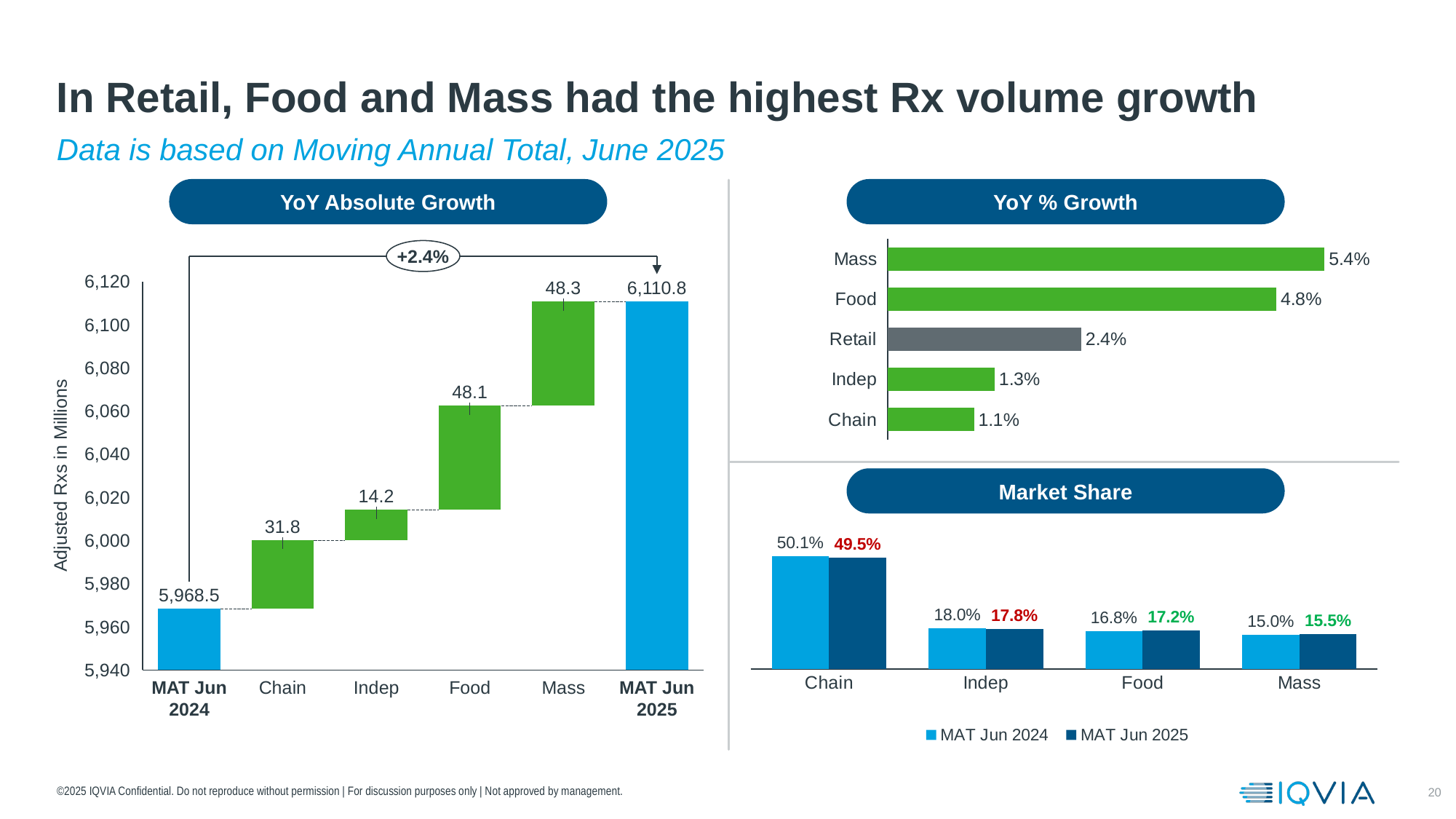
In the Market Share chart, what is the MAT Jun 2025 value for Food? 17.2% In the YoY Absolute Growth chart, what is the value for MAT Jun 2025? 6,110.8 What kind of chart is the YoY % Growth chart? Bar chart In the YoY % Growth chart, what is the value for Food? 4.8% In the YoY % Growth chart, how many categories are shown? 5 In the Market Share chart, which is larger for Mass: MAT Jun 2024 or MAT Jun 2025? MAT Jun 2025 In the YoY % Growth chart, which category has the lowest value? Chain In the YoY Absolute Growth chart, what is the value for MAT Jun 2024? 5,968.5 In the Market Share chart, how many series does the legend list? 2 In the YoY Absolute Growth chart, what is the growth contribution shown for Indep? 14.2 In the YoY Absolute Growth chart, which channel has the largest growth contribution? Mass In the YoY Absolute Growth chart, what is the difference between the Chain and Indep growth contributions? 17.6